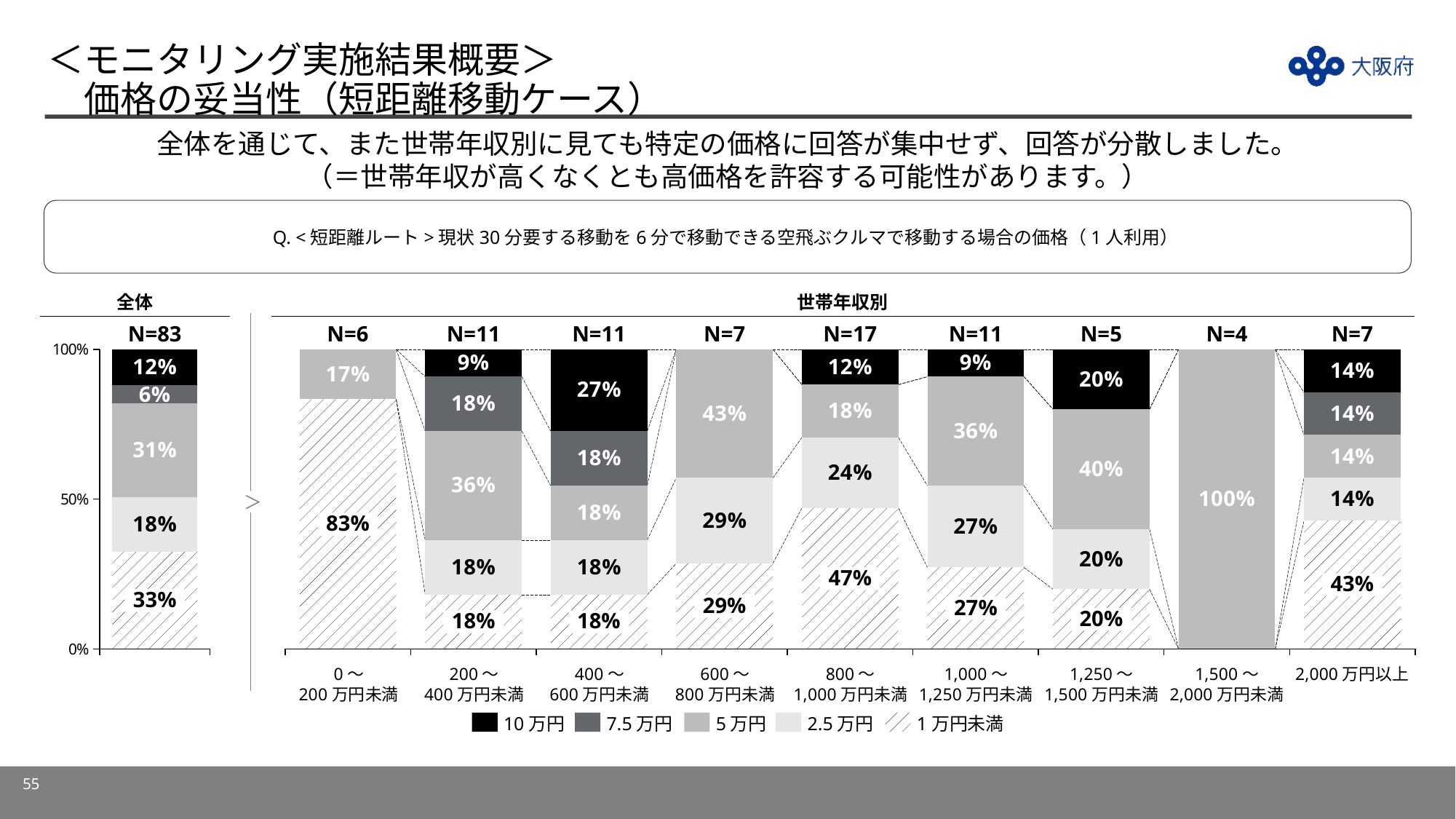
In the 世帯年収別 chart, which is larger: the 1万円未満 share for 800〜1,000万円未満 or for 1,000〜1,250万円未満? 800〜1,000万円未満 In the 全体 chart on the left, which price option has the smallest share? 7.5万円 In the 全体 chart on the left, what percentage of respondents chose 1万円未満? 33% What type of chart is used for the 世帯年収別 data? Stacked bar chart In the 世帯年収別 chart, what is the 1万円未満 share for the 0〜200万円未満 group? 83% In the 世帯年収別 chart, what is the 10万円 share for the 400〜600万円未満 group? 27% In the 世帯年収別 chart, how many household income categories are shown? 9 In the 世帯年収別 chart, what is the difference between the 5万円 share and the 10万円 share for the 1,250〜1,500万円未満 group? 20% In the 世帯年収別 chart, what is the sample size (N) for the 800〜1,000万円未満 group? N=17 In the 世帯年収別 chart, what is the 5万円 share for the 1,500〜2,000万円未満 group? 100% In the 全体 chart on the left, what percentage of respondents chose 10万円? 12% How many price options does the legend list? 5